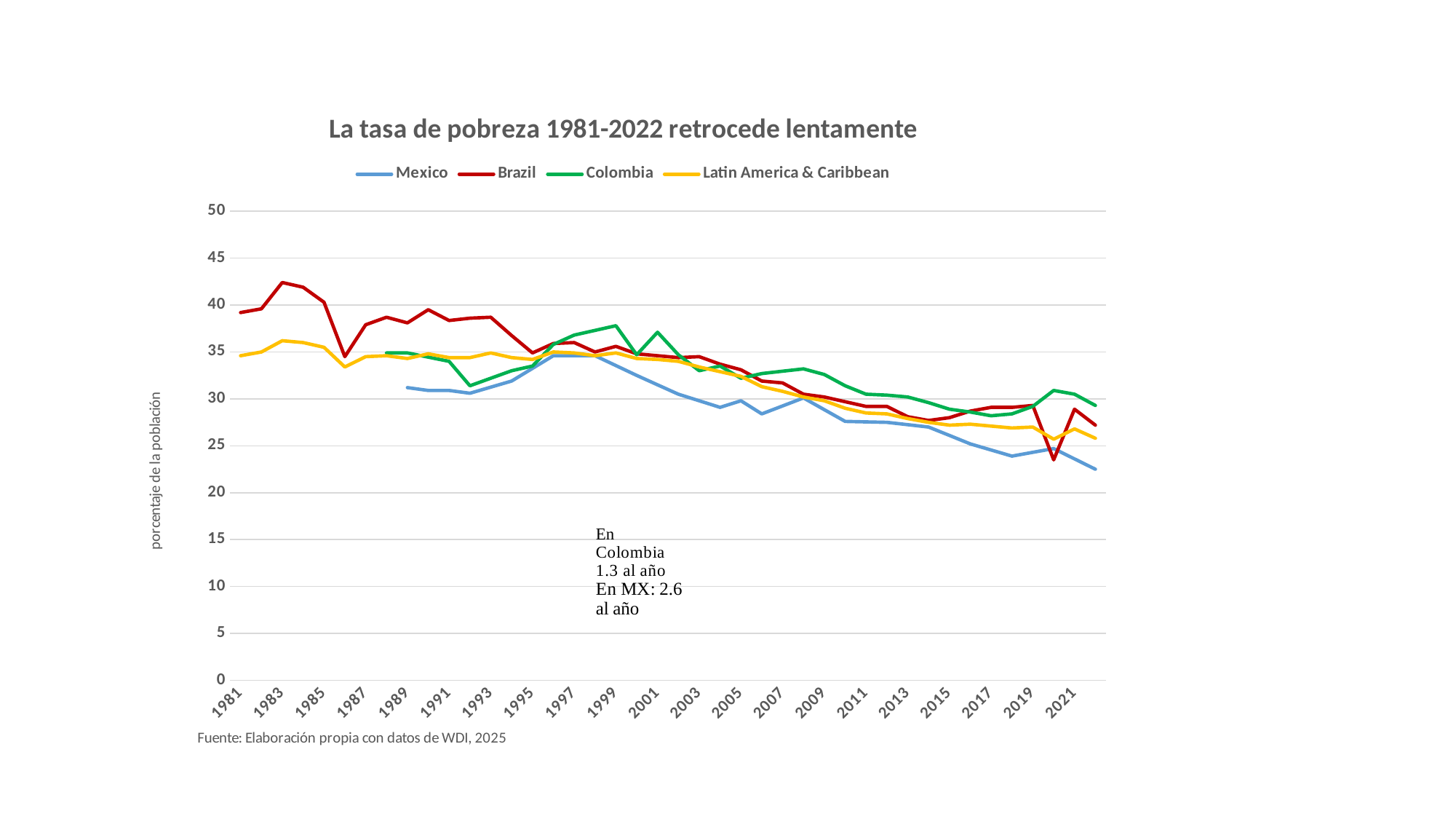
Does the Mexico series generally rise or fall from 1989 to 2022? fall In 2009, which is larger: the value for Colombia or the value for Mexico? Colombia Is the value for Brazil in 1983 greater or less than 40? greater Which series has the lowest value in 2021? Mexico What is the title of the chart? La tasa de pobreza 1981-2022 retrocede lentamente Is the value for Mexico in 2021 greater or less than 25? less Which series is drawn in red? Brazil What kind of chart is shown on the slide? line chart Which series has the highest value in 1983? Brazil Is the value for Colombia in 1999 greater or less than 35? greater How many series does the legend list? 4